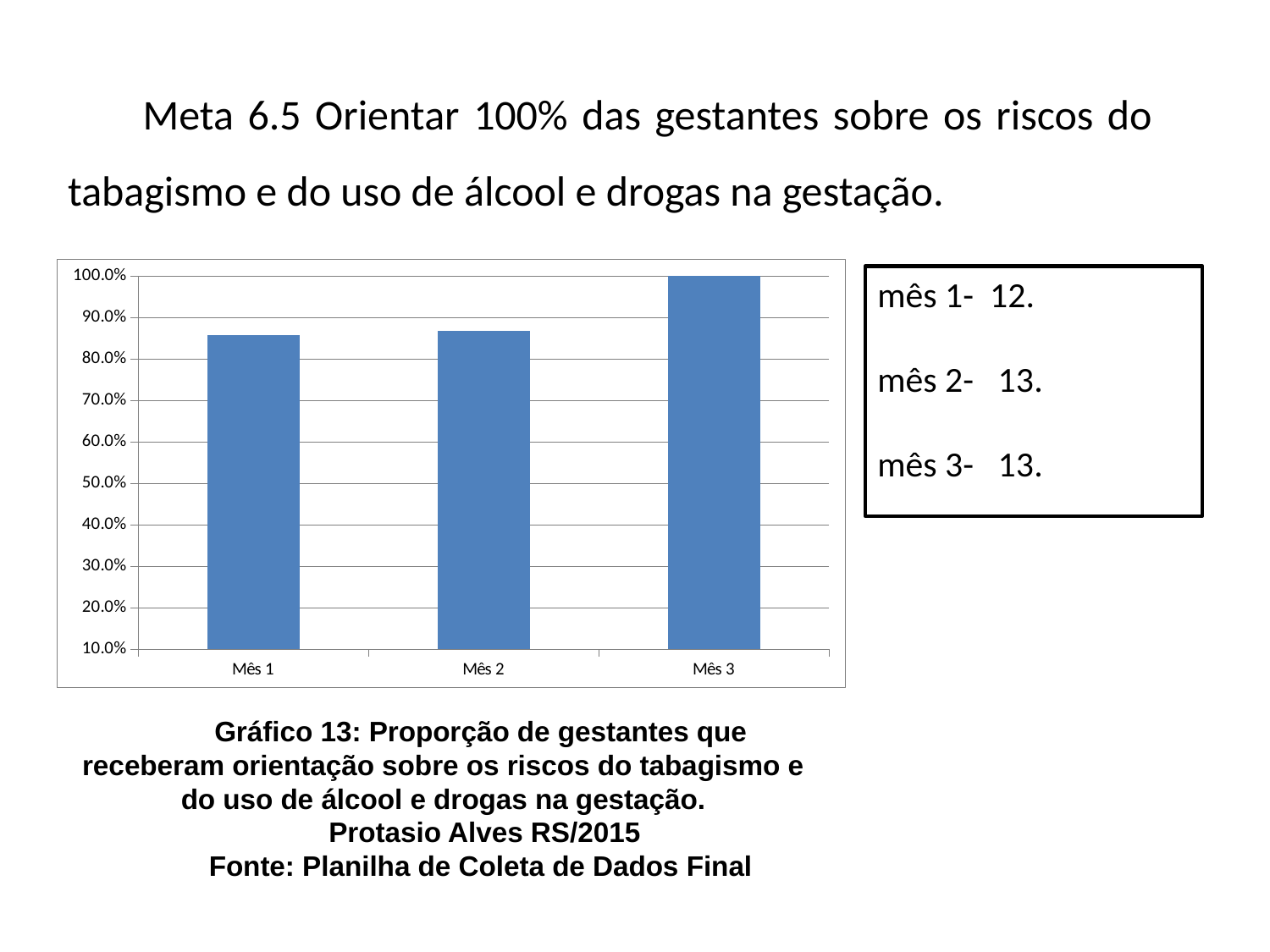
How many bars (categories) does the chart show? 3 What kind of chart is shown on the slide? bar chart What is the value for Mês 3 in the chart? 100.0% Which month has the highest value in the chart? Mês 3 Is the value for Mês 1 greater or less than 90.0%? less Do the values rise or fall from Mês 1 to Mês 3? rise Is the value for Mês 2 greater or less than 80.0%? greater What is the number of the chart given in the caption below it? Gráfico 13 Is the value for Mês 2 greater or less than 90.0%? less Which is larger, the value for Mês 1 or the value for Mês 3? Mês 3 What are the category labels on the x axis of the chart? Mês 1, Mês 2, Mês 3